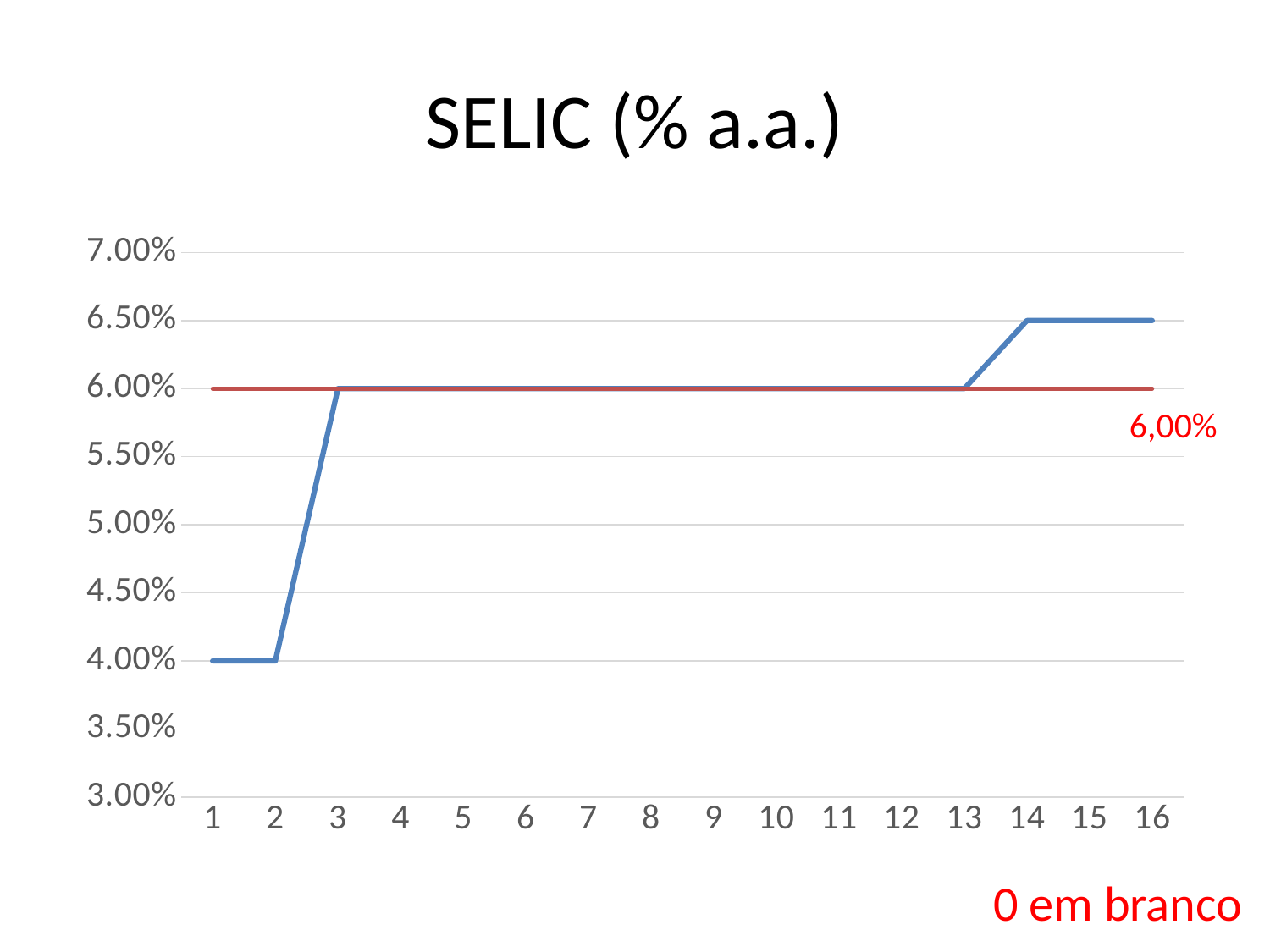
What constant value does the red horizontal line mark? 6,00% Does the blue line rise or fall from point 1 to point 16? rise What is the title of the chart? SELIC (% a.a.) How many points are on the x axis of the chart? 16 At which point does the blue line first reach 6.00%? 3 What is the value of the blue line at point 8? 6.00% What is the value of the blue line at point 16? 6.50% What kind of chart is shown on the slide? line chart Which is larger, the blue line's value at point 1 or at point 14? point 14 Is the value of the blue line at point 15 greater or less than 6.00%? greater What is the value of the blue line at point 1? 4.00% Is the value of the blue line at point 2 greater or less than 5.00%? less